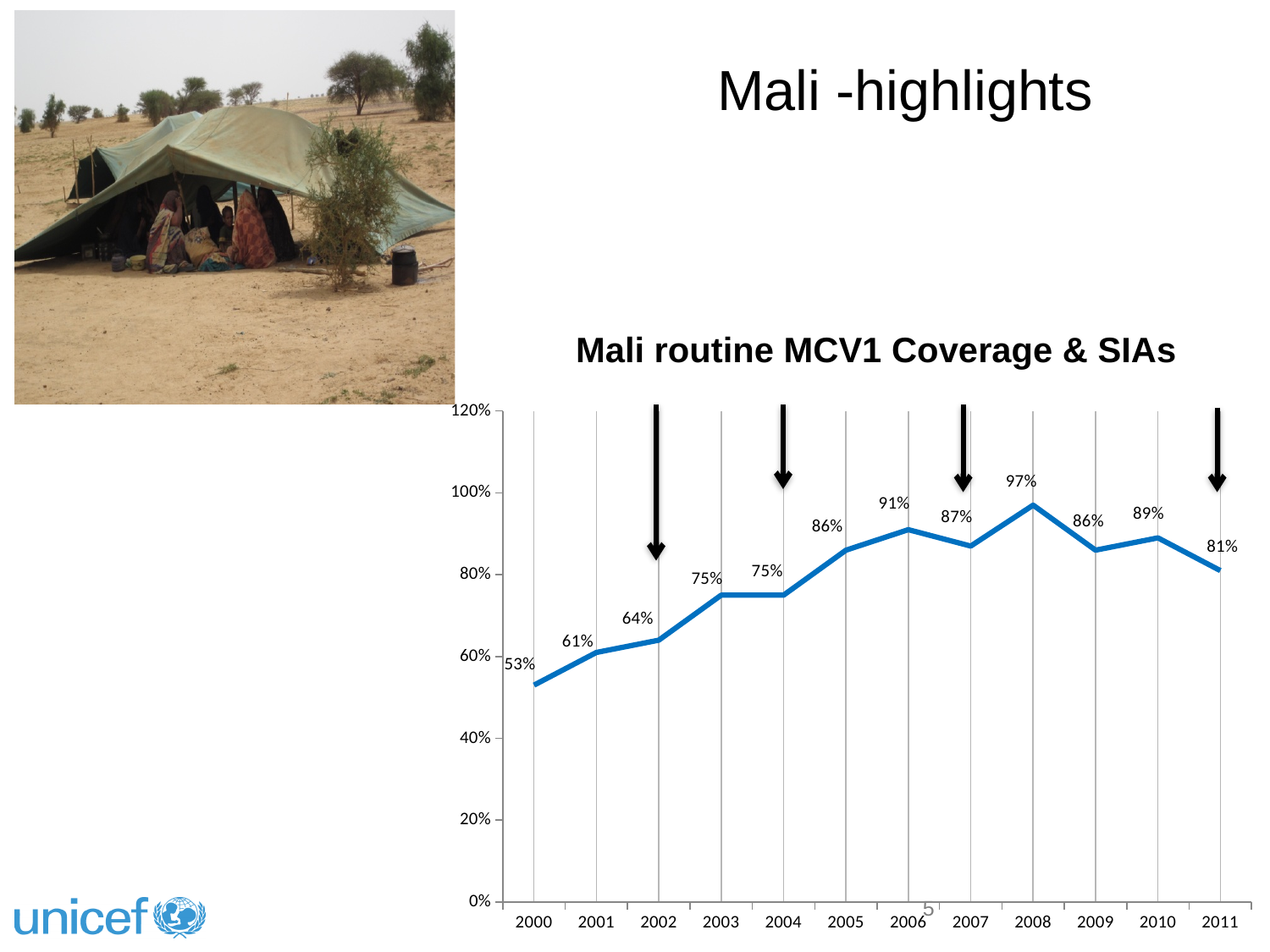
What kind of chart is used to show Mali's routine MCV1 coverage? line chart Which year had higher MCV1 coverage, 2006 or 2007? 2006 What was Mali's routine MCV1 coverage in 2008? 97% In which year was Mali's routine MCV1 coverage highest? 2008 Is the MCV1 coverage value for 2003 greater or less than 80%? less What was Mali's routine MCV1 coverage in 2000? 53% What was Mali's routine MCV1 coverage in 2011? 81% In which year was Mali's routine MCV1 coverage lowest? 2000 By how many percentage points did Mali's MCV1 coverage change from 2000 to 2008? 44 percentage points How many years are plotted on the x axis of the chart? 12 What is the difference between the 2010 and 2011 MCV1 coverage values? 8 percentage points What is the title of the chart on the slide? Mali routine MCV1 Coverage & SIAs